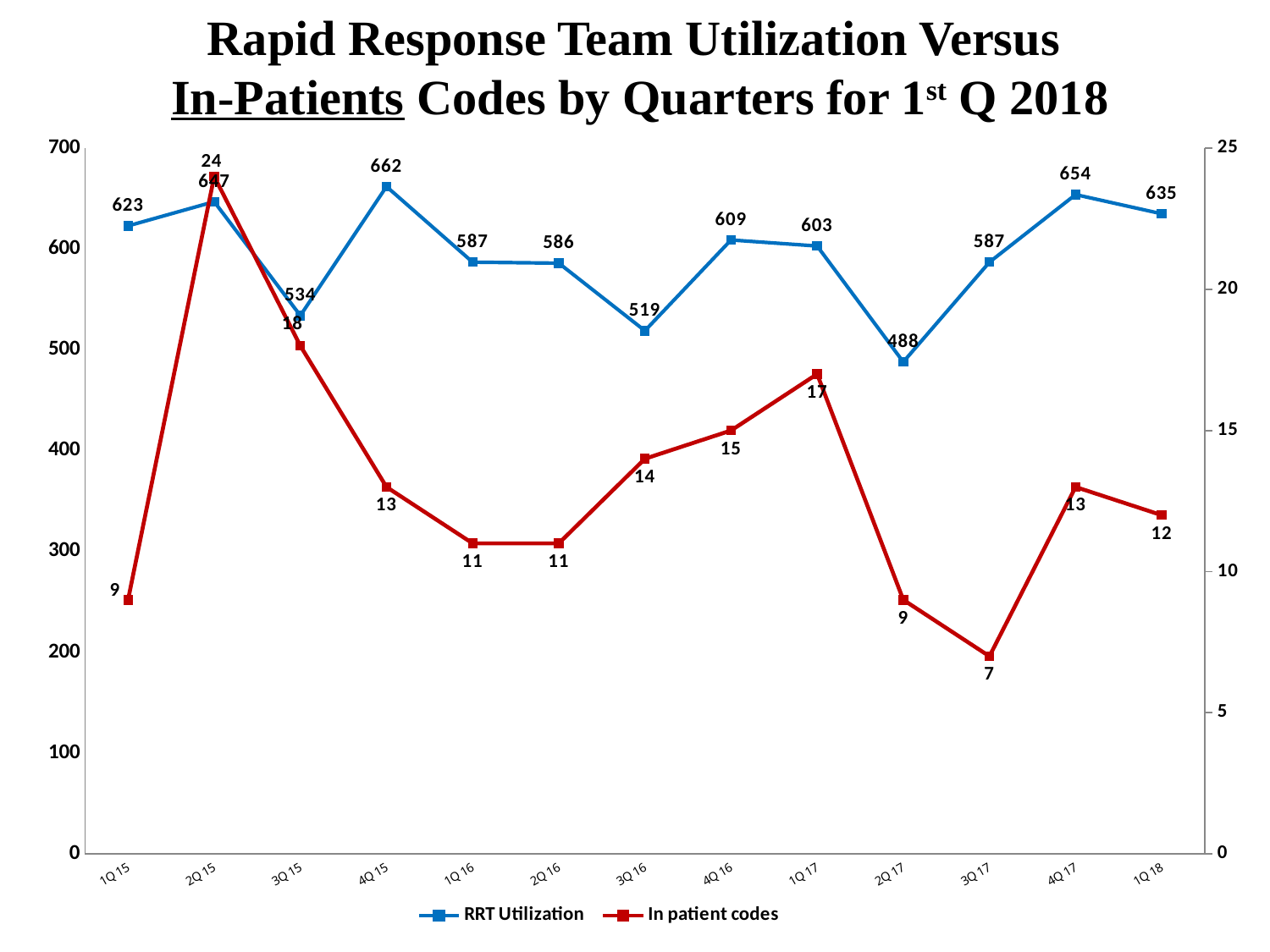
How many series does the legend list? 2 Which is larger, the In patient codes value for 1Q 17 or for 4Q 17? 1Q 17 What type of chart is shown on the slide? line chart In which quarter is RRT Utilization lowest? 2Q 17 In which quarter is the In patient codes value highest? 2Q 15 Does RRT Utilization rise or fall from 2Q 17 to 4Q 17? rise What is the RRT Utilization value for 4Q 15? 662 How many quarters are plotted along the x axis? 13 Which colour is used for the In patient codes series? red Is the RRT Utilization value for 3Q 16 greater or less than 600? less What is the difference between RRT Utilization in 4Q 15 and in 2Q 17? 174 What is the In patient codes value for 3Q 17? 7